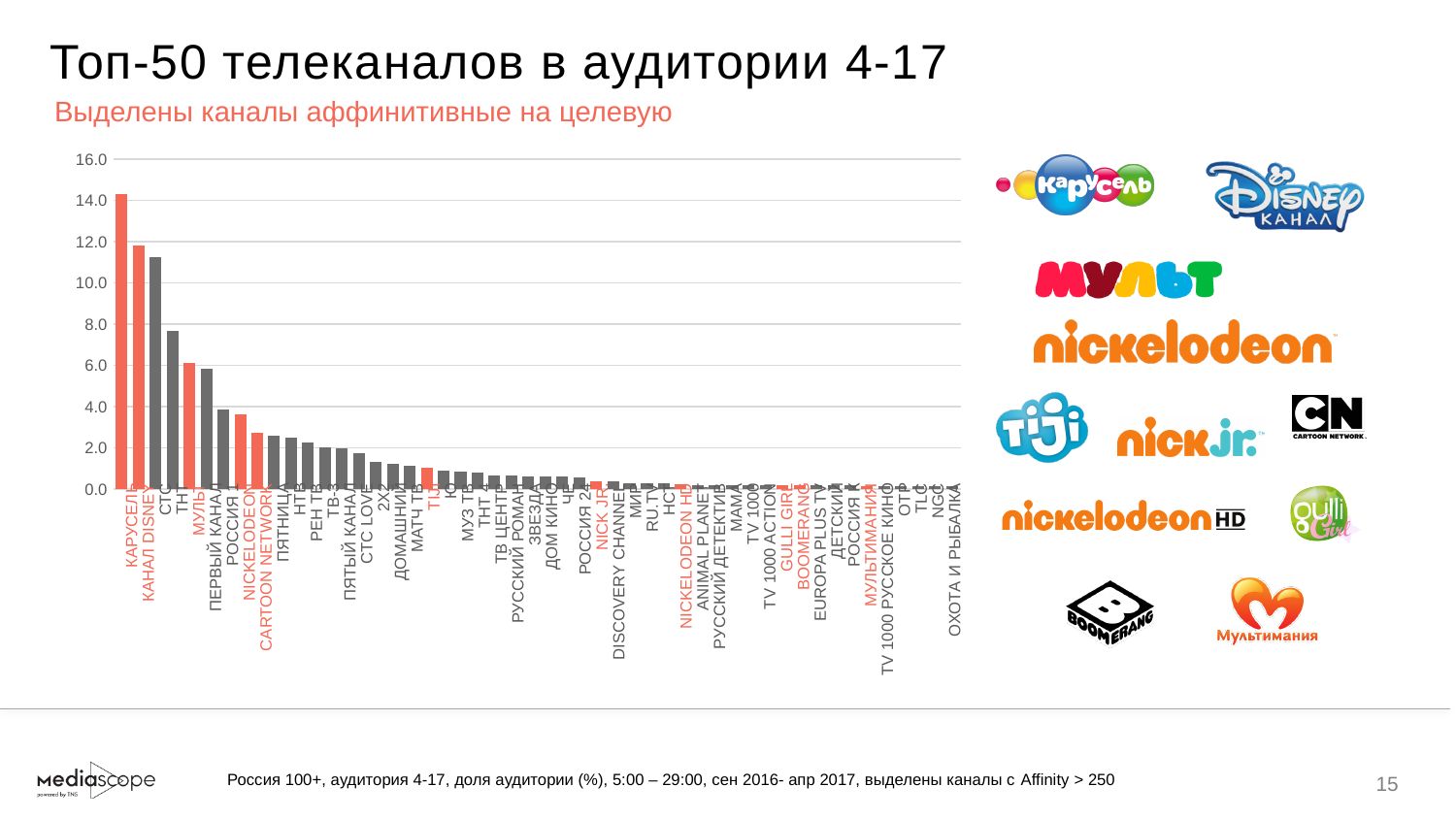
Which is larger, the value for КАРУСЕЛЬ or the value for КАНАЛ DISNEY? КАРУСЕЛЬ Do the values rise or fall from left to right along the x axis? fall What kind of chart is shown on the slide? bar chart Is the value for МУЛЬТ greater or less than 8.0? less Is the value for КАРУСЕЛЬ greater or less than 12.0? greater Is the value for NICKELODEON greater or less than 2.0? greater Which channel has the highest value in the chart? КАРУСЕЛЬ What is the title of the slide containing the chart? Топ-50 телеканалов в аудитории 4-17 Which is larger, the value for ТНТ or the value for МУЛЬТ? ТНТ